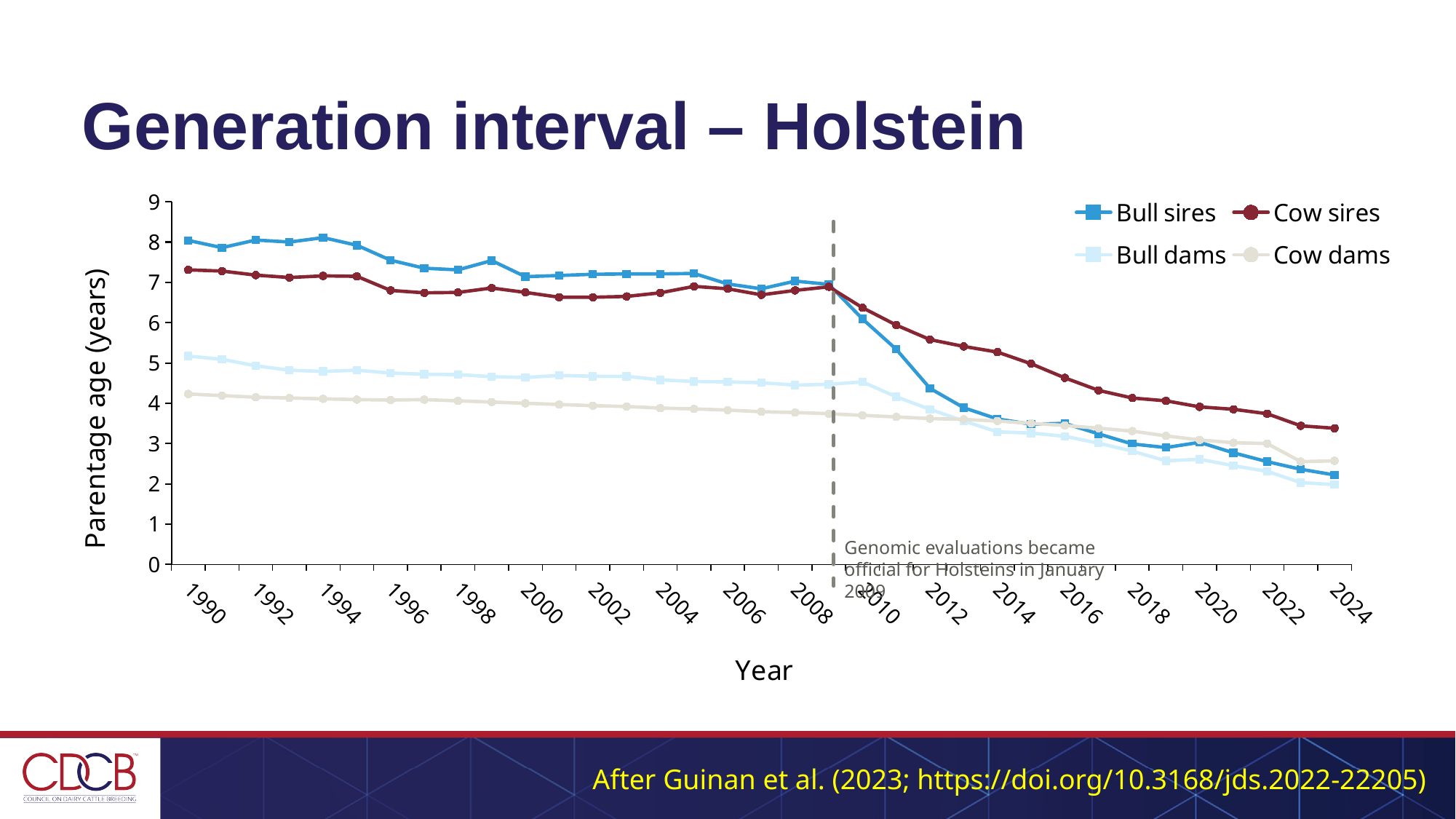
In 2000, which is larger: the value for Bull dams or the value for Cow dams? Bull dams Which series has the highest parentage age in 2024? Cow sires What kind of chart is shown on the slide? Line chart What is the label of the y axis? Parentage age (years) Which series has the highest parentage age in 1990? Bull sires What is the title of the chart on the slide? Generation interval – Holstein Which series has the lowest parentage age in 1990? Cow dams Is the value for Bull sires in 2024 greater or less than 3? less Is the value for Bull sires in 1990 greater or less than 7? greater How many series does the legend list? 4 Does the Bull sires series rise or fall from 1990 to 2024? Fall Is the value for Cow sires in 2024 greater or less than 4? less